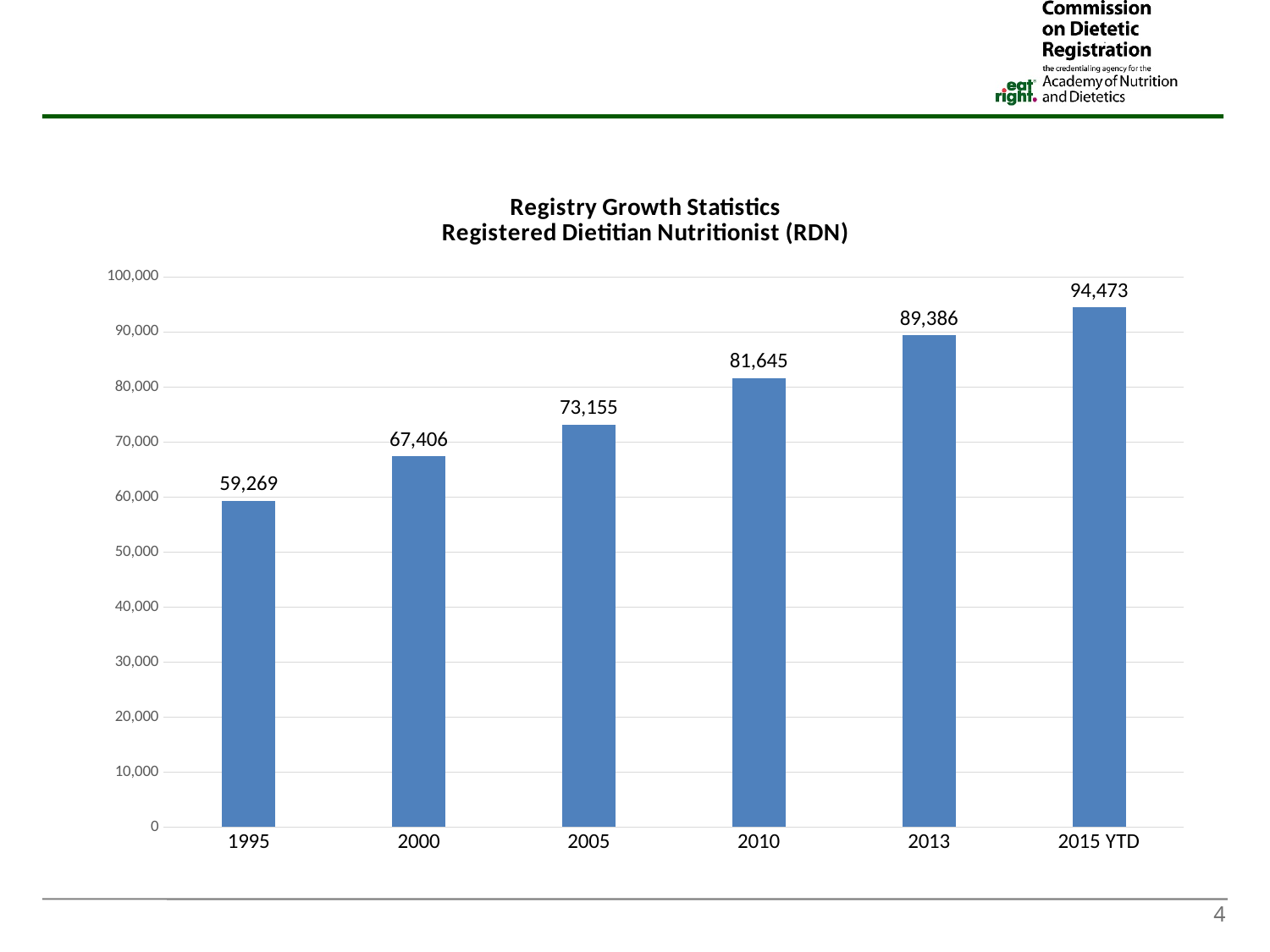
Do the values rise or fall from 1995 to 2015 YTD? Rise Is the value for 2013 greater or less than 80,000? greater Which year has the highest value? 2015 YTD What is the value for 2010? 81,645 What is the value for 2015 YTD? 94,473 What is the difference between the values for 2013 and 2010? 7,741 Which year has the lowest value? 1995 How many years are shown on the x axis? 6 What kind of chart is this? Bar chart What is the difference between the values for 2005 and 2000? 5,749 What is the value for 1995? 59,269 Which is larger, the value for 2000 or the value for 2005? 2005